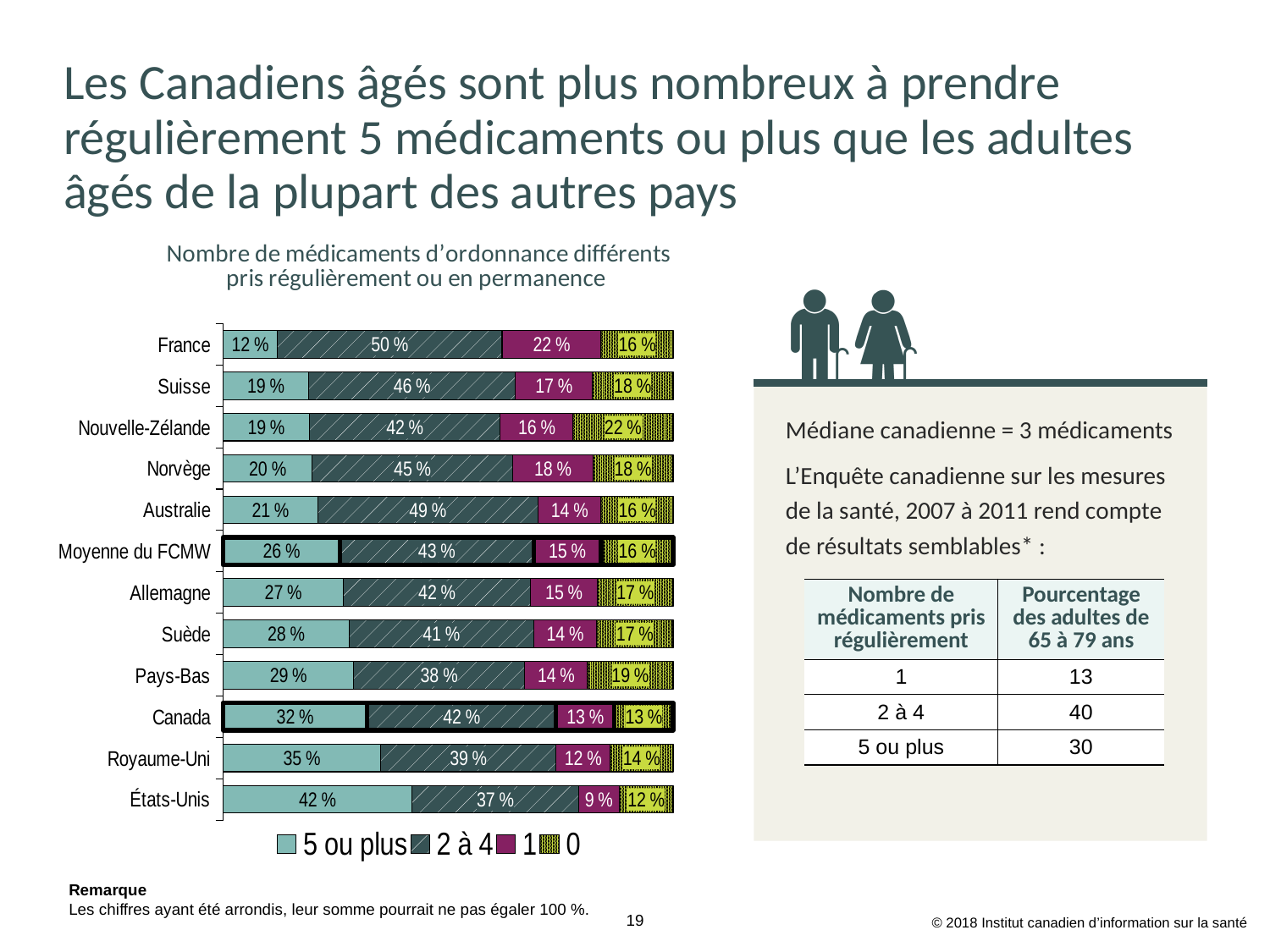
What is the value of the "0" segment for Nouvelle-Zélande? 22 % What kind of chart is shown on the slide? Stacked bar chart What is the value of the "2 à 4" segment for France? 50 % What is the difference between Canada's "5 ou plus" value and the "Moyenne du FCMW" value for the same series? 6 percentage points How many categories (countries and averages) are shown on the chart? 12 Which country has the highest value for the "5 ou plus" series? États-Unis Which country has the lowest value for the "5 ou plus" series? France Which has a larger "1" segment, France or États-Unis? France What is the total of the four segments for the Royaume-Uni bar? 100 % How many series does the legend list? 4 What percentage of older adults in Canada take 5 or more prescription medications regularly ("5 ou plus")? 32 % What is the title of the chart? Nombre de médicaments d'ordonnance différents pris régulièrement ou en permanence